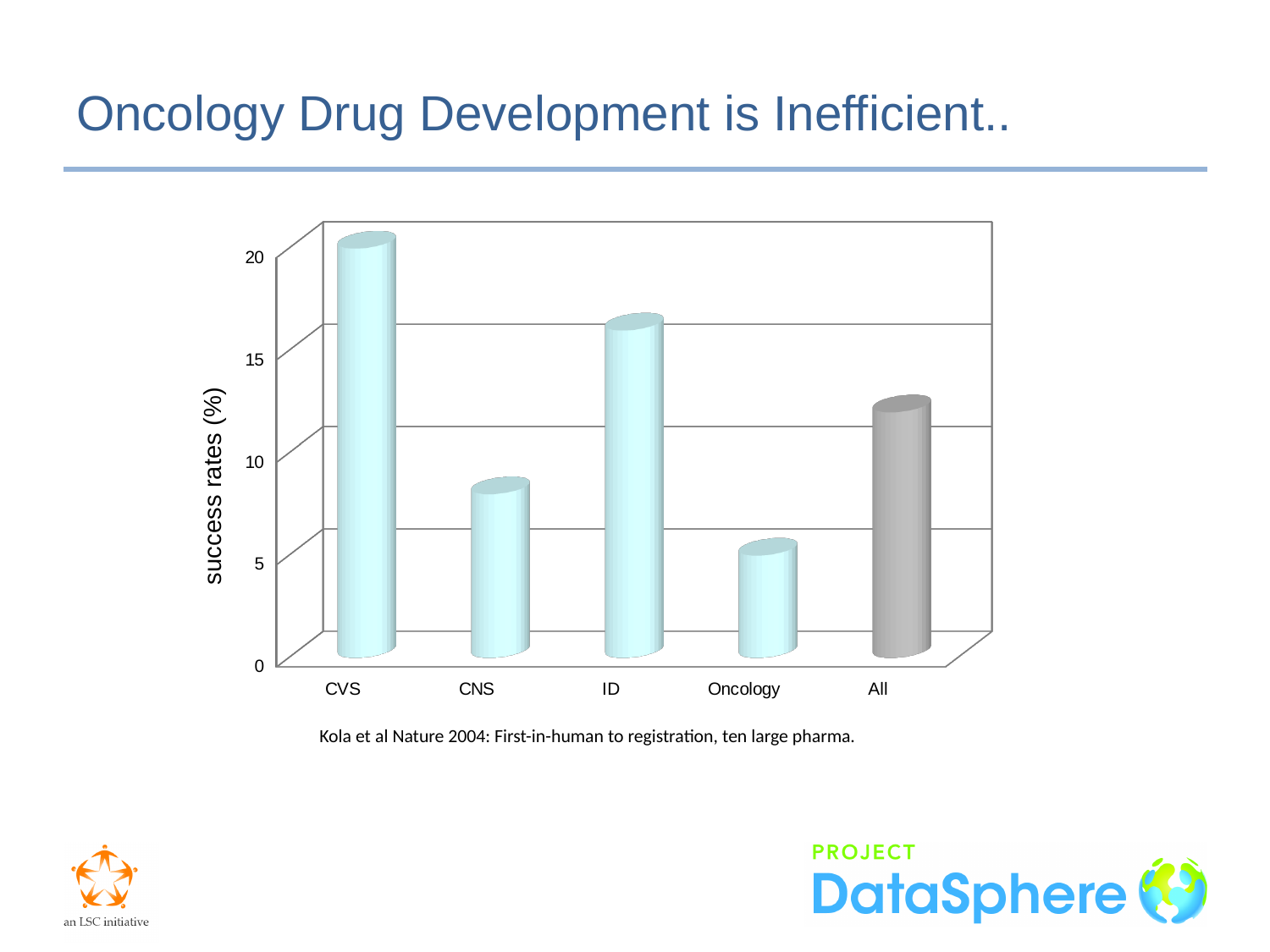
What kind of chart is shown on the slide? bar chart Is the success rate for CNS greater or less than 10? less Which has a higher success rate, ID or Oncology? ID Is the success rate for Oncology greater or less than 10? less Is the success rate for ID greater or less than 10? greater How many categories are shown on the x axis of the chart? 5 Which category has the lowest success rate? Oncology Which has a higher success rate, CNS or All? All Which category has the highest success rate? CVS What is the label on the vertical axis of the chart? success rates (%)